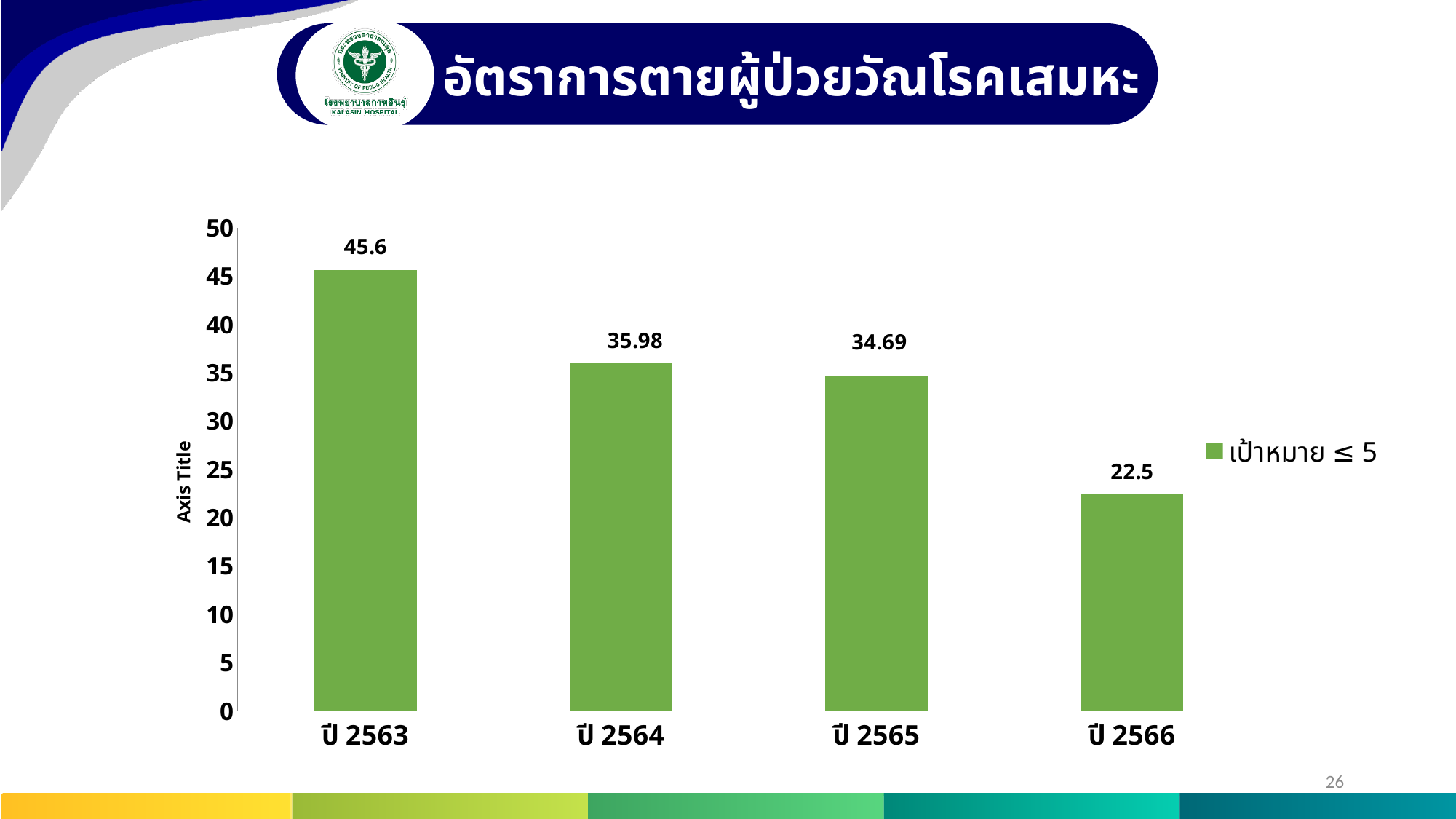
What is the value for ปี 2565? 34.69 Which year has the lowest value? ปี 2566 What is the value for ปี 2566? 22.5 What is the value for ปี 2564? 35.98 What is the legend entry shown on the chart? เป้าหมาย ≤ 5 What kind of chart is shown on the slide? Bar chart What is the difference between the values for ปี 2563 and ปี 2566? 23.1 Do the values rise or fall from ปี 2563 to ปี 2566? Fall What is the value for ปี 2563? 45.6 Which is larger, the value for ปี 2564 or ปี 2565? ปี 2564 Which year has the highest value? ปี 2563 How many years are shown on the x axis? 4